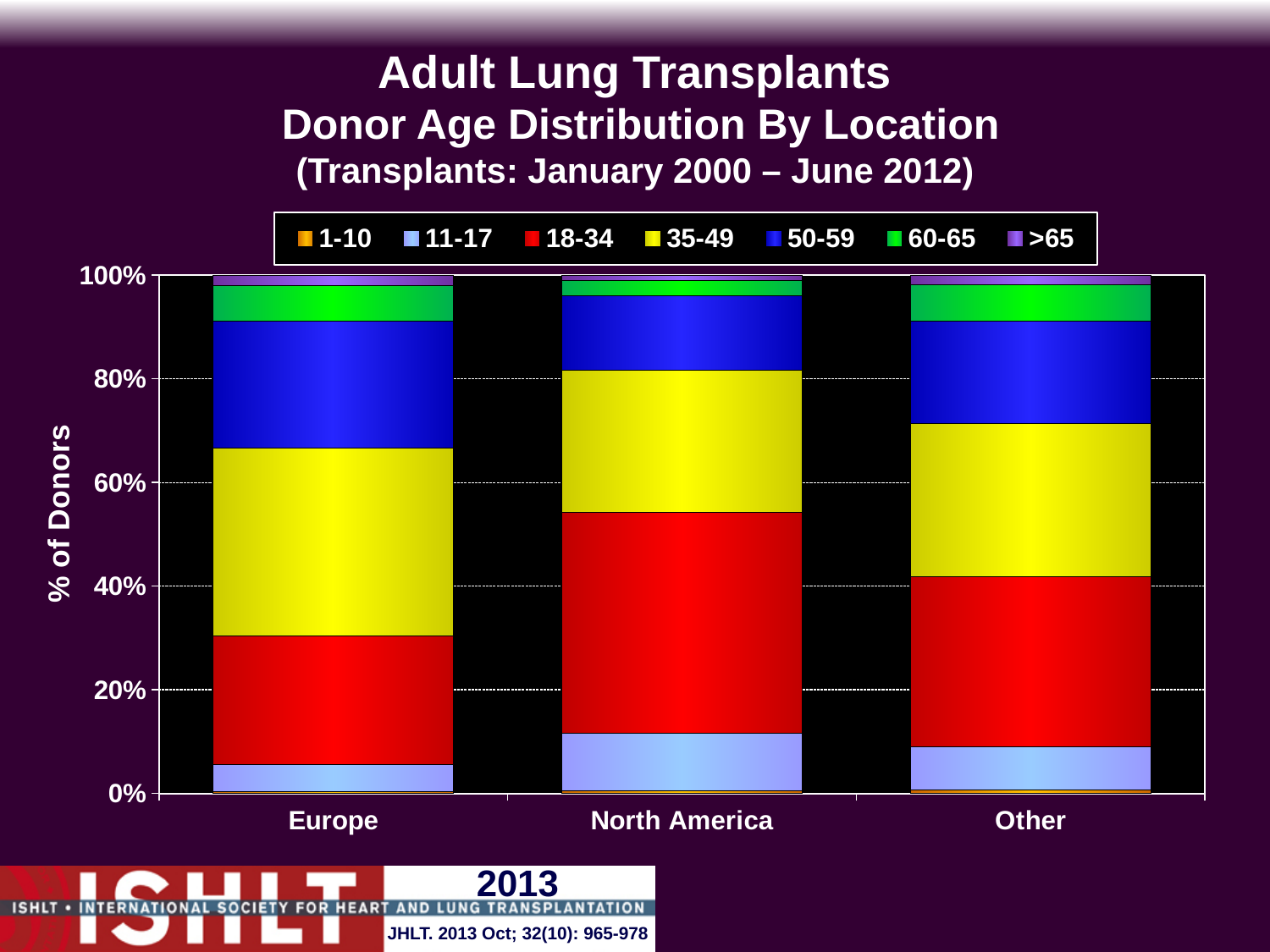
Which location has the smallest share of donors aged 11-17? Europe Is the share of donors aged 18-34 larger in Europe or in North America? North America How many donor age groups does the legend list? 7 What is the label on the y axis of the chart? % of Donors In the Europe bar, which age group makes up the largest share of donors? 35-49 Which location has the largest share of donors aged 18-34? North America What time period of transplants does the chart title cover? January 2000 – June 2012 Is the share of donors aged 35-49 larger in Europe or in North America? Europe In the Europe bar, is the share of donors aged 11-17 greater or less than 20%? less What kind of chart is shown on the slide? Stacked bar chart In the North America bar, is the share of donors aged 18-34 greater or less than 20%? greater How many locations are shown on the x axis of the chart? 3